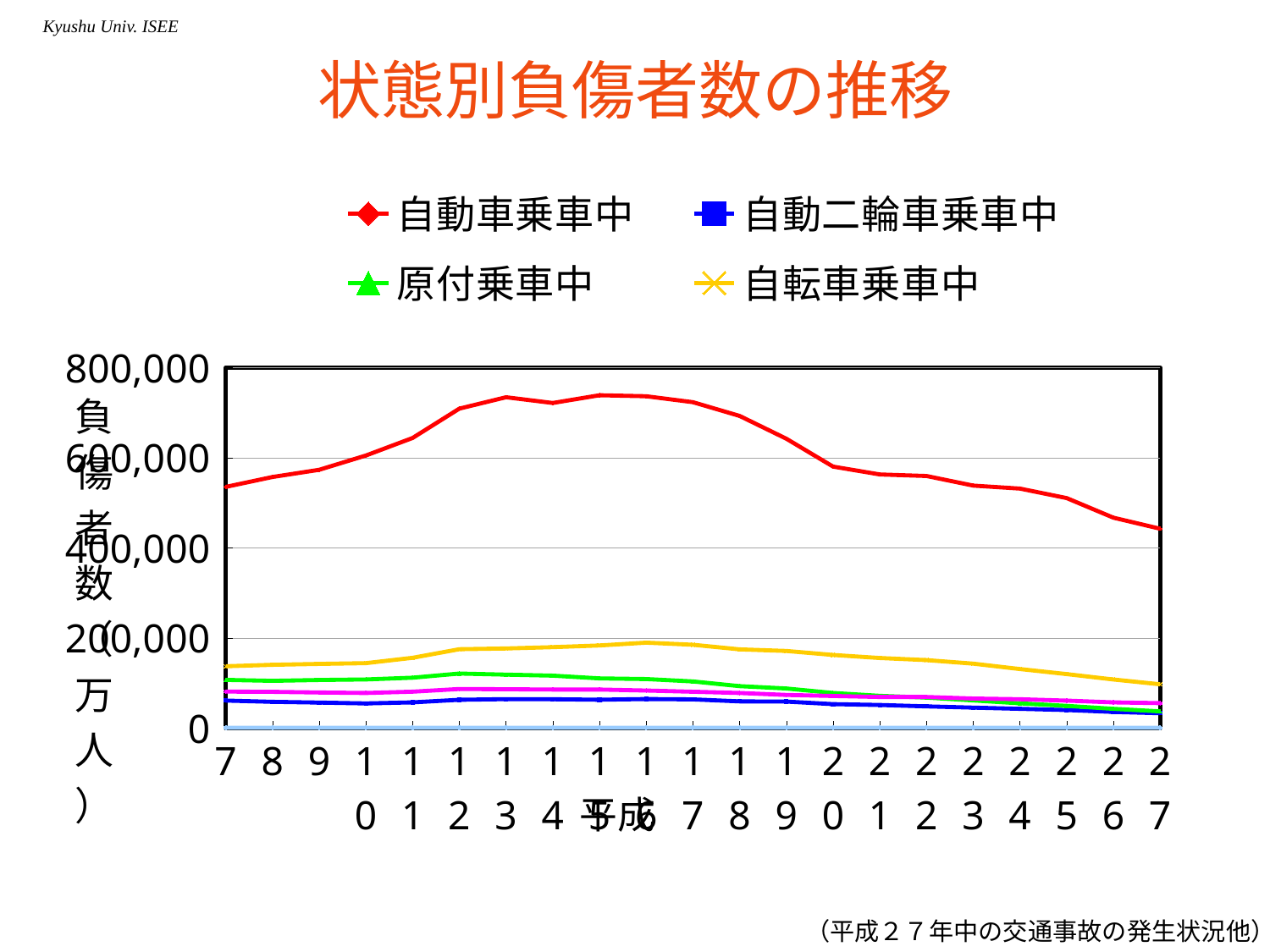
Is the value for 自動車乗車中 in 平成27 greater or less than 600,000? less Is the value for 自動車乗車中 in 平成16 greater or less than 600,000? greater Does the 自動車乗車中 line rise or fall from 平成7 to 平成16? rise What is the title of the chart? 状態別負傷者数の推移 Which series has the highest values throughout the chart? 自動車乗車中 Does the 自動車乗車中 line rise or fall from 平成16 to 平成27? fall In 平成20, which is larger: 自転車乗車中 or 原付乗車中? 自転車乗車中 What kind of chart is shown on the slide? line chart How many series does the legend list? 4 How many years (points) are shown along the x axis? 21 Is the value for 自転車乗車中 in 平成27 greater or less than 200,000? less